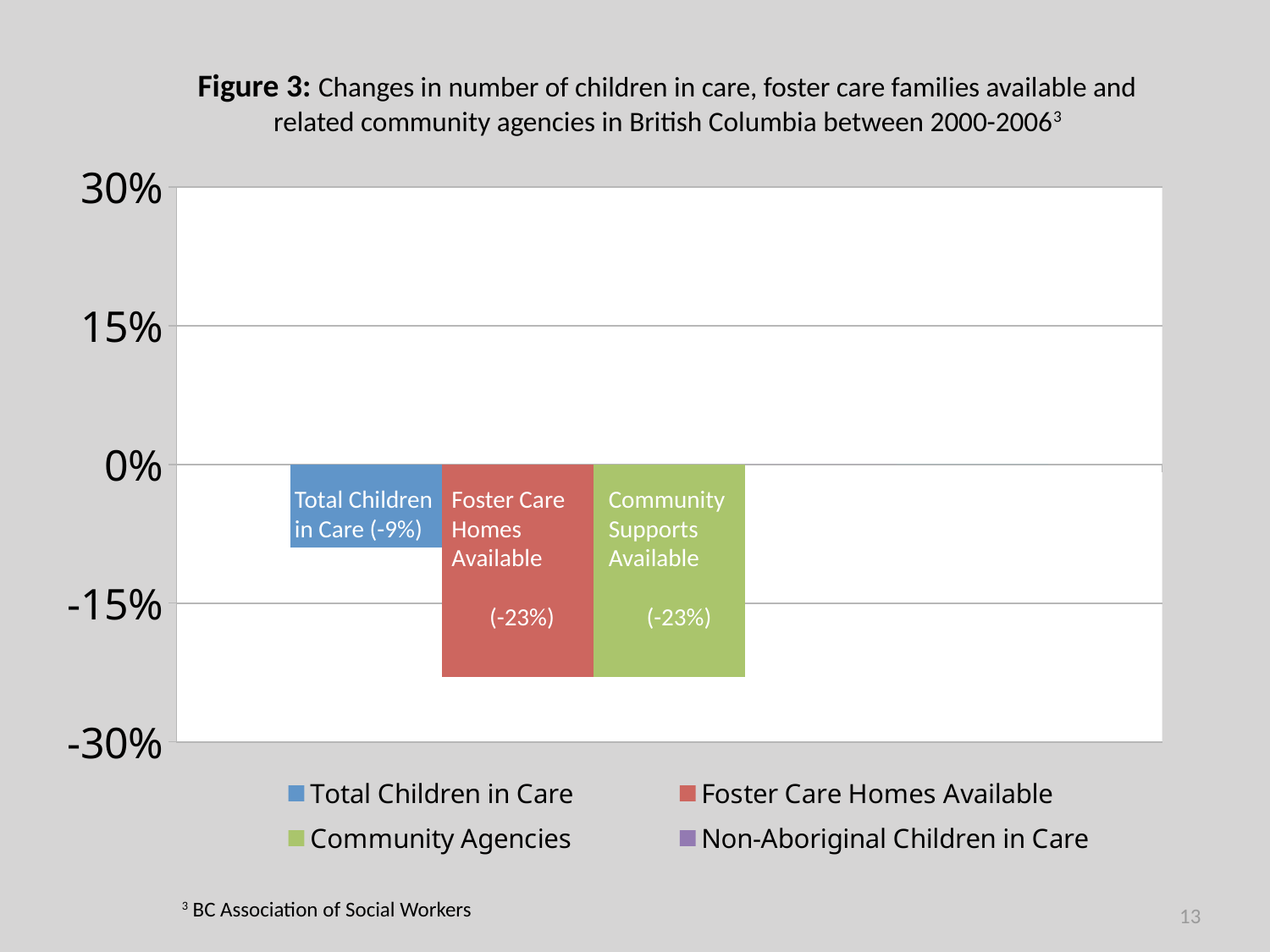
Which bar has the highest (least negative) value? Total Children in Care What is the value shown for Total Children in Care? -9% How many series does the legend list? 4 Is the value for Total Children in Care greater or less than -15%? greater What is the value shown for Foster Care Homes Available? -23% What is the difference between the value for Total Children in Care (-9%) and the value for Foster Care Homes Available (-23%)? 14 percentage points What is the value shown for Community Supports Available? -23% What kind of chart is shown on the slide? Bar chart Which is larger, the value for Total Children in Care or the value for Foster Care Homes Available? Total Children in Care Which legend entry has no visible bar on the chart? Non-Aboriginal Children in Care How many bars are plotted on the chart? 3 Is the value for Foster Care Homes Available greater or less than -15%? less